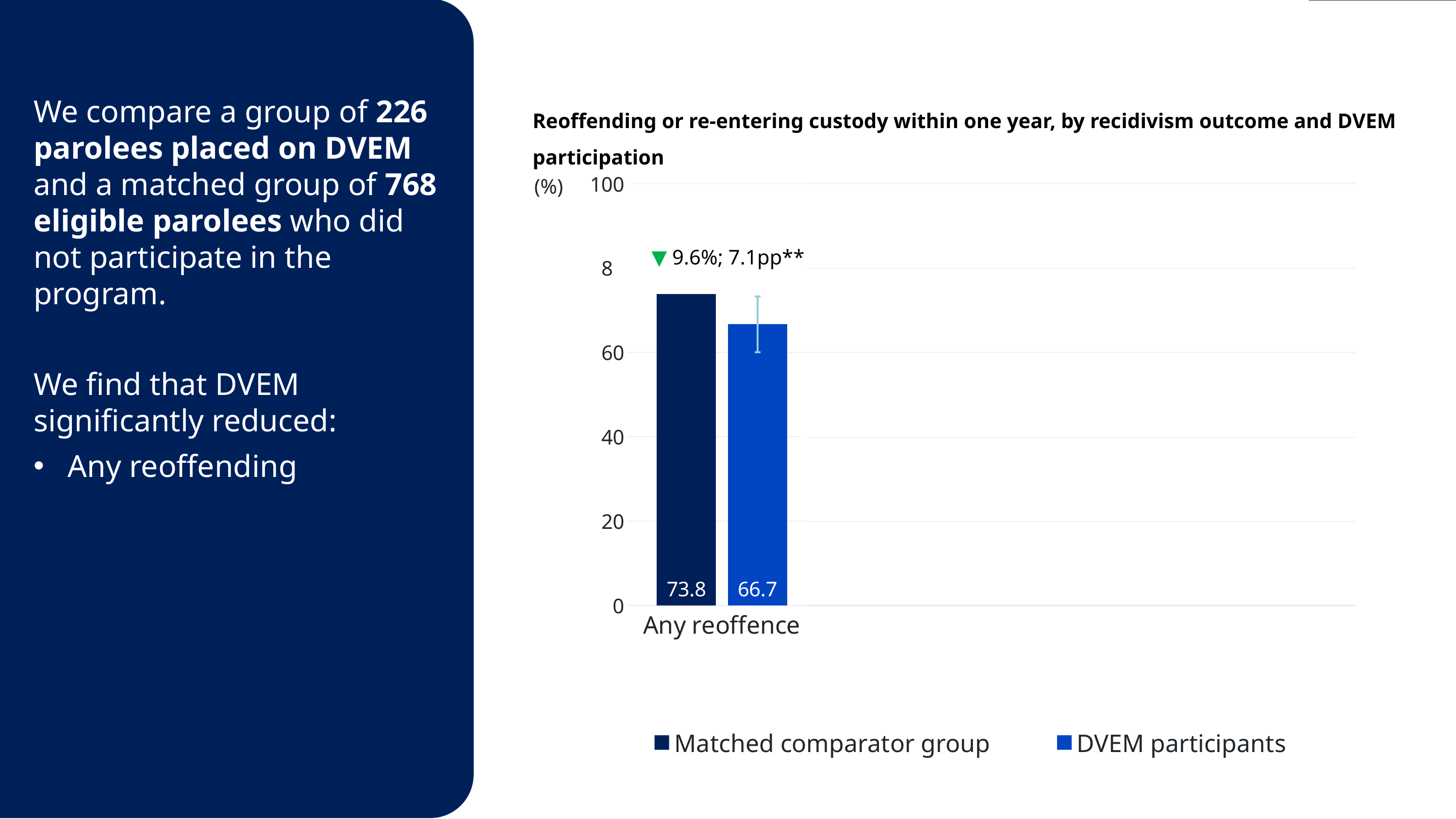
What is the value for DVEM participants for Any reoffence? 66.7 How many series does the legend list? 2 How many categories are shown on the x axis? 1 What is the value for the Matched comparator group for Any reoffence? 73.8 Is the value for DVEM participants for Any reoffence greater or less than 60? greater What is the difference between the Matched comparator group and DVEM participants values for Any reoffence? 7.1 What kind of chart is shown on the slide? Bar chart Is the value for the Matched comparator group for Any reoffence greater or less than 80? less What is the title of the chart? Reoffending or re-entering custody within one year, by recidivism outcome and DVEM participation What annotation is printed above the bars for Any reoffence? ▼ 9.6%; 7.1pp** Which series has the higher value for Any reoffence, Matched comparator group or DVEM participants? Matched comparator group What is the category label on the x axis? Any reoffence